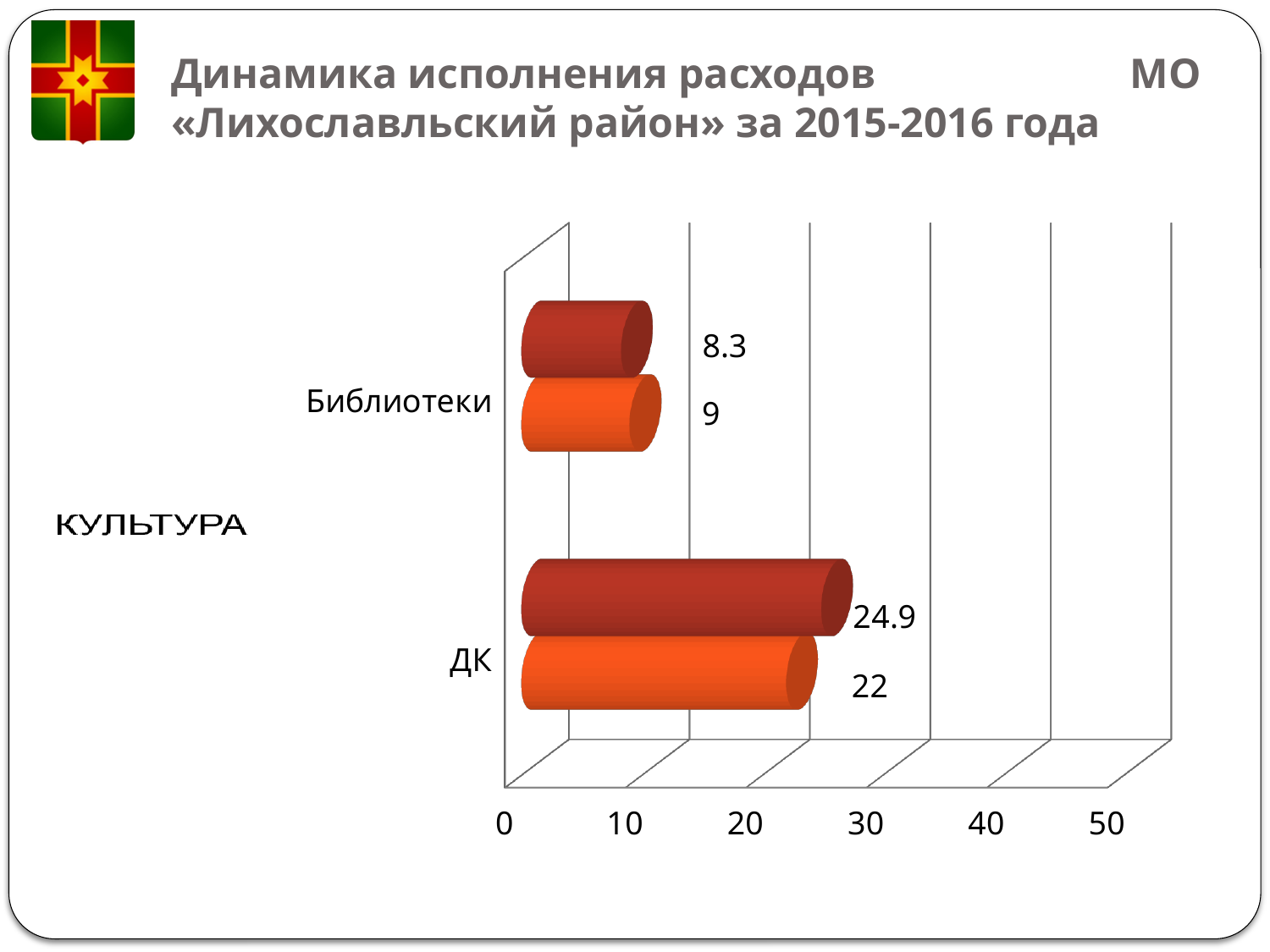
What is the value of the orange bar for ДК? 22 Is the dark red value for ДК greater or less than 20? greater Which category has the highest value on the chart? ДК What kind of chart is shown on the slide? bar chart What is the value of the dark red bar for Библиотеки? 8.3 How many categories are plotted on the chart? 2 What is the difference between the dark red bar and the orange bar for ДК? 2.9 What is the value of the dark red bar for ДК? 24.9 What is the value of the orange bar for Библиотеки? 9 What is the highest value shown on the horizontal axis? 50 Which is larger for Библиотеки: the dark red bar or the orange bar? the orange bar Which category has the lowest value on the chart? Библиотеки